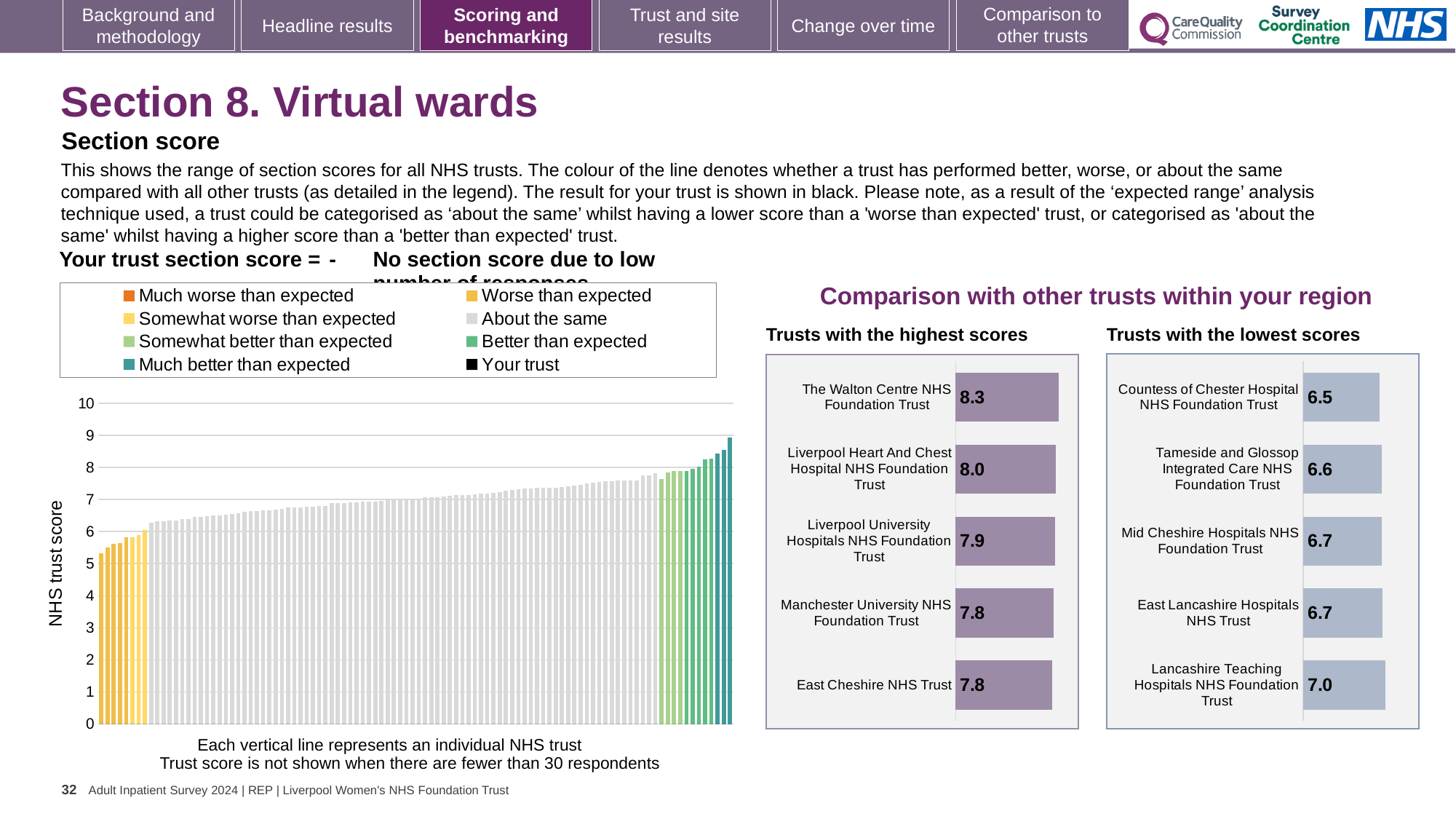
In the large NHS trust score chart on the left, do the bar values rise or fall from left to right? rise In the 'Trusts with the highest scores' chart, what is the difference between the scores of The Walton Centre NHS Foundation Trust and East Cheshire NHS Trust? 0.5 In the 'Trusts with the highest scores' chart, which trust has the highest score? The Walton Centre NHS Foundation Trust In the 'Trusts with the lowest scores' chart, what is the difference between the scores of Lancashire Teaching Hospitals NHS Foundation Trust and Countess of Chester Hospital NHS Foundation Trust? 0.5 In the 'Trusts with the lowest scores' chart, what is the score for Lancashire Teaching Hospitals NHS Foundation Trust? 7.0 How many entries does the legend of the large NHS trust score chart list? 8 Which is larger: the score for Liverpool Heart And Chest Hospital NHS Foundation Trust in the highest scores chart, or the score for Tameside and Glossop Integrated Care NHS Foundation Trust in the lowest scores chart? Liverpool Heart And Chest Hospital NHS Foundation Trust How many trusts are shown in the 'Trusts with the highest scores' chart? 5 In the 'Trusts with the lowest scores' chart, what is the score for Countess of Chester Hospital NHS Foundation Trust? 6.5 In the 'Trusts with the lowest scores' chart, which trust has the lowest score? Countess of Chester Hospital NHS Foundation Trust In the 'Trusts with the highest scores' chart, what is the score for Liverpool University Hospitals NHS Foundation Trust? 7.9 In the 'Trusts with the highest scores' chart, what is the score for The Walton Centre NHS Foundation Trust? 8.3